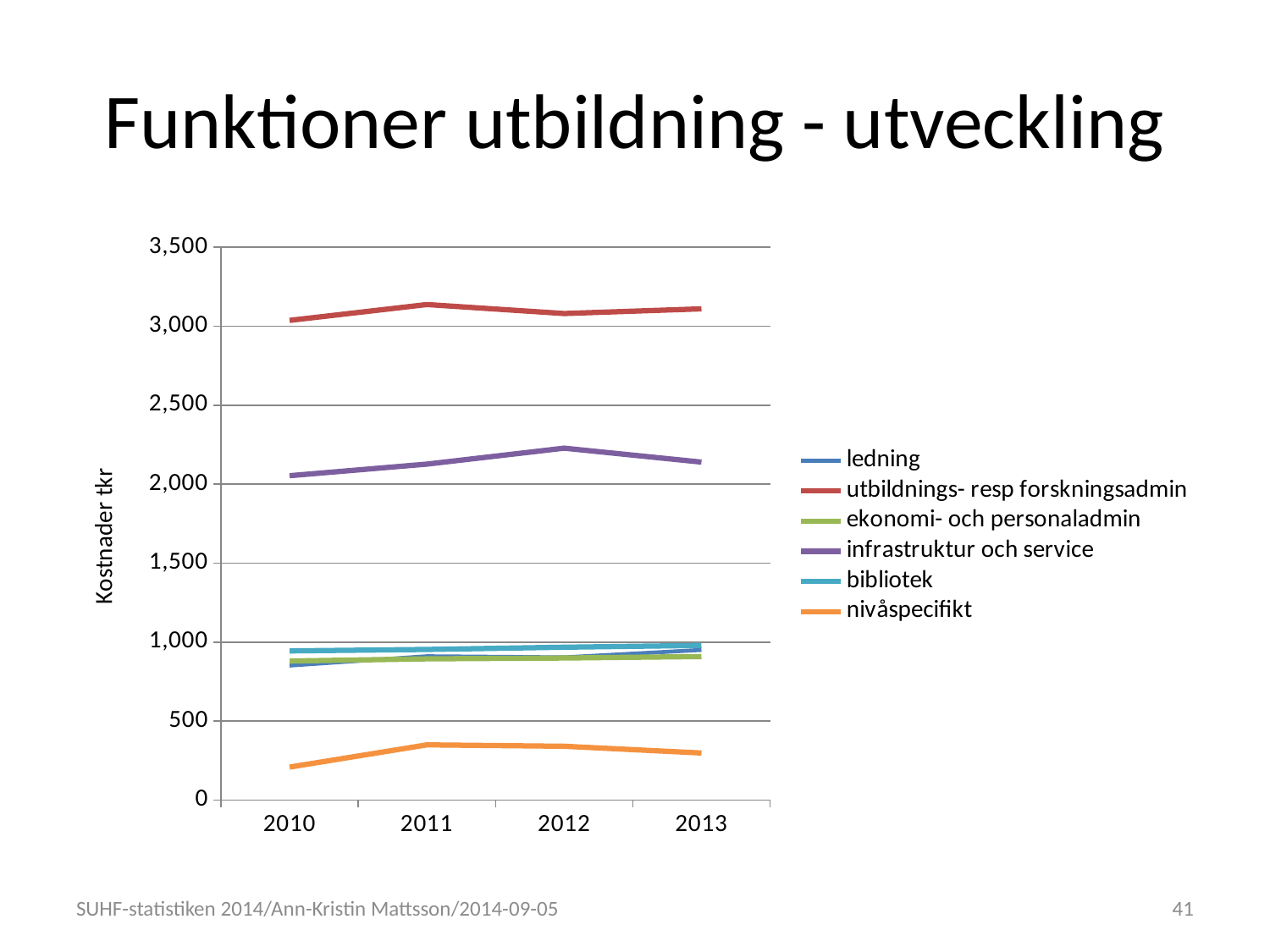
What is the label on the y axis? Kostnader tkr Is the value for nivåspecifikt in 2010 greater or less than 500? less How many years are plotted along the x axis? 4 How many series does the legend list? 6 Is the value for ledning in 2010 greater or less than 1,000? less Does the value for nivåspecifikt rise or fall from 2010 to 2011? rise What kind of chart is shown on the slide? line chart Which series has the lowest values across all years? nivåspecifikt Is the value for utbildnings- resp forskningsadmin in 2011 greater or less than 3,000? greater Which series has the highest values across all years? utbildnings- resp forskningsadmin Which is larger in 2013: infrastruktur och service or bibliotek? infrastruktur och service